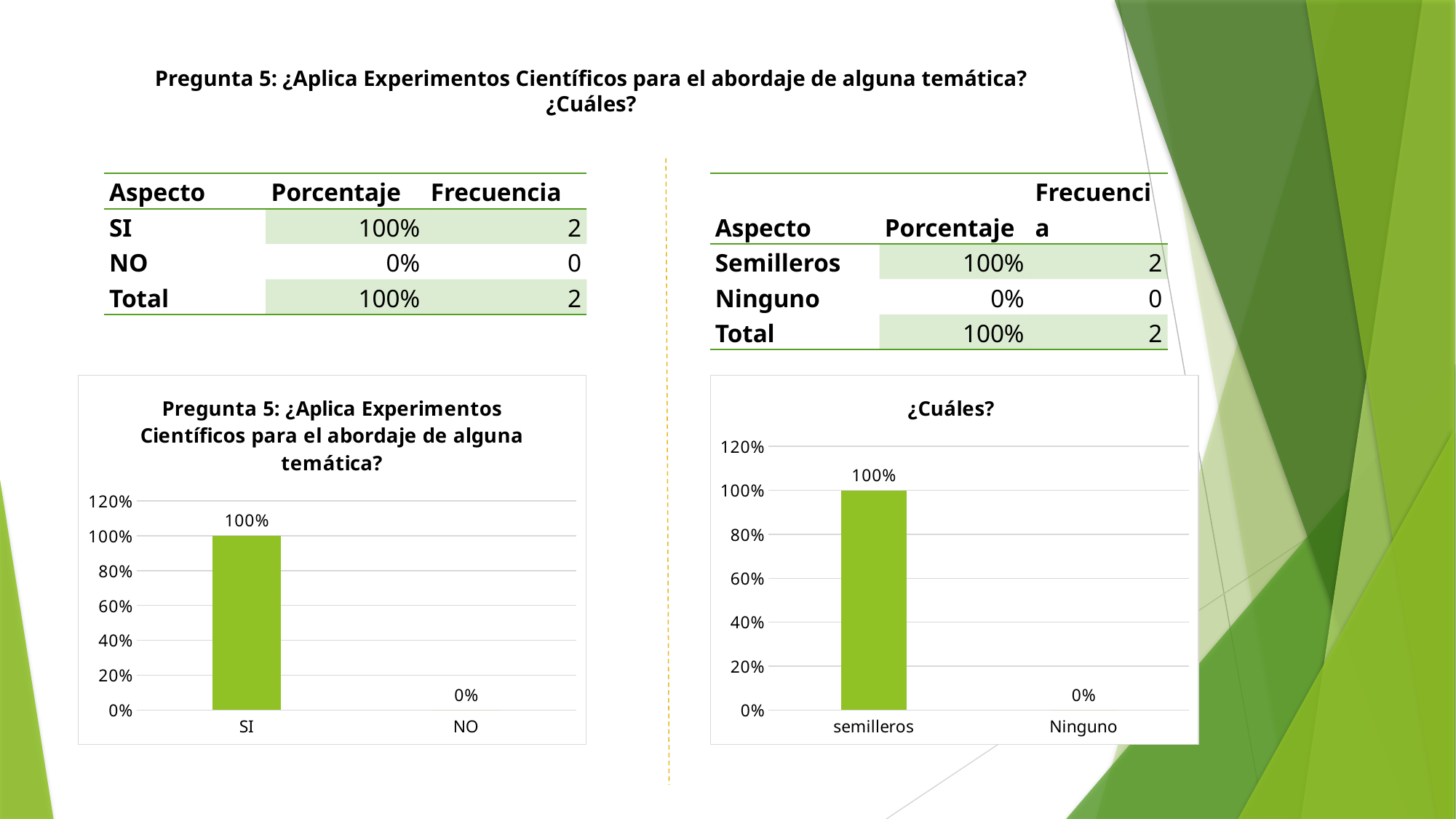
In the left chart titled 'Pregunta 5: ¿Aplica Experimentos Científicos para el abordaje de alguna temática?', what is the value for NO? 0% In the right chart titled '¿Cuáles?', which category has the lowest value? Ninguno In the left chart titled 'Pregunta 5: ¿Aplica Experimentos Científicos para el abordaje de alguna temática?', what is the value for SI? 100% In the right chart titled '¿Cuáles?', what is the value for semilleros? 100% In the right chart titled '¿Cuáles?', do the values rise or fall from left to right along the x axis? Fall In the left chart titled 'Pregunta 5: ¿Aplica Experimentos Científicos para el abordaje de alguna temática?', which category has the highest value? SI In the right chart titled '¿Cuáles?', which is larger, the value for semilleros or the value for Ninguno? semilleros In the right chart titled '¿Cuáles?', what is the value for Ninguno? 0% In the right chart titled '¿Cuáles?', what is the highest value shown on the vertical axis? 120% In the left chart titled 'Pregunta 5: ¿Aplica Experimentos Científicos para el abordaje de alguna temática?', what is the difference between the values for SI and NO? 100% In the left chart titled 'Pregunta 5: ¿Aplica Experimentos Científicos para el abordaje de alguna temática?', how many categories are shown on the x axis? 2 What kind of chart is the left chart titled 'Pregunta 5: ¿Aplica Experimentos Científicos para el abordaje de alguna temática?'? Bar chart